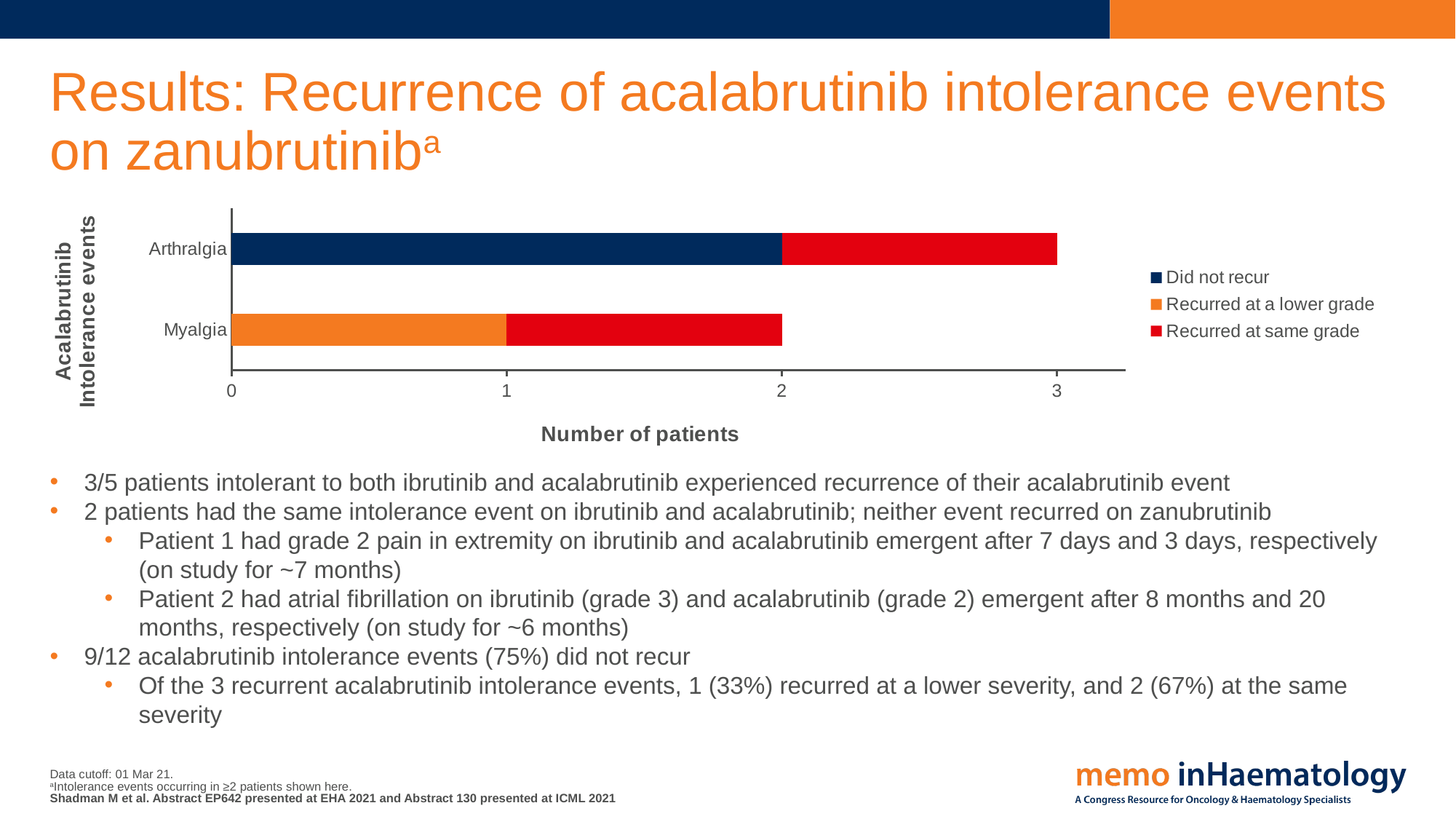
What kind of chart is shown on the slide? Bar chart How many series does the legend list? 3 How many patients with Arthralgia recurred at the same grade? 1 What is the label of the x axis of the chart? Number of patients Which intolerance event has the higher total number of patients, Arthralgia or Myalgia? Arthralgia How many patients with Arthralgia did not recur? 2 How many acalabrutinib intolerance events are shown on the y axis of the chart? 2 How many patients with Myalgia recurred at a lower grade? 1 What is the total number of patients for the Arthralgia bar? 3 Which legend series is shown in orange? Recurred at a lower grade What is the total number of patients for the Myalgia bar? 2 What is the difference between the total number of patients for Arthralgia and for Myalgia? 1